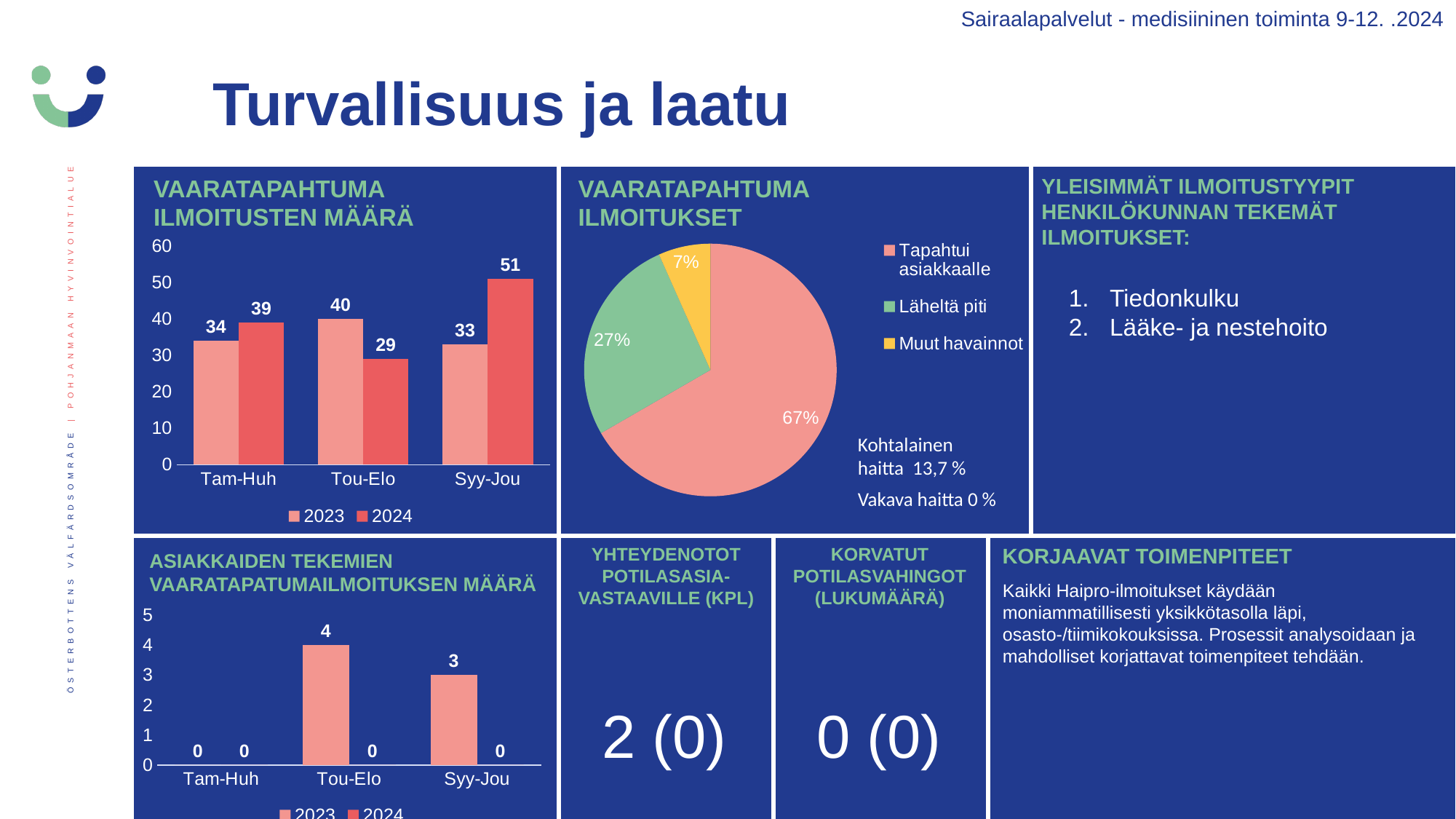
In the chart titled 'VAARATAPAHTUMA ILMOITUSTEN MÄÄRÄ', which is larger in Tou-Elo, the 2023 value or the 2024 value? 2023 In the chart titled 'ASIAKKAIDEN TEKEMIEN VAARATAPATUMAILMOITUKSEN MÄÄRÄ', what is the value for 2023 in Tou-Elo? 4 In the chart titled 'VAARATAPAHTUMA ILMOITUSTEN MÄÄRÄ', what is the difference between the 2024 and 2023 values in Tam-Huh? 5 In the chart titled 'VAARATAPAHTUMA ILMOITUSTEN MÄÄRÄ', which category has the highest 2024 value? Syy-Jou In the chart titled 'VAARATAPAHTUMA ILMOITUSTEN MÄÄRÄ', what is the value for 2024 in Syy-Jou? 51 What kind of chart is the chart titled 'VAARATAPAHTUMA ILMOITUKSET'? Pie chart In the chart titled 'VAARATAPAHTUMA ILMOITUSTEN MÄÄRÄ', how many categories are shown on the x axis? 3 In the pie chart titled 'VAARATAPAHTUMA ILMOITUKSET', what share does 'Läheltä piti' have? 27% In the chart titled 'VAARATAPAHTUMA ILMOITUSTEN MÄÄRÄ', what is the value for 2023 in Tou-Elo? 40 In the chart titled 'VAARATAPAHTUMA ILMOITUSTEN MÄÄRÄ', how many series does the legend list? 2 In the pie chart titled 'VAARATAPAHTUMA ILMOITUKSET', which slice is the smallest? Muut havainnot In the chart titled 'ASIAKKAIDEN TEKEMIEN VAARATAPATUMAILMOITUKSEN MÄÄRÄ', what is the value for 2024 in Syy-Jou? 0